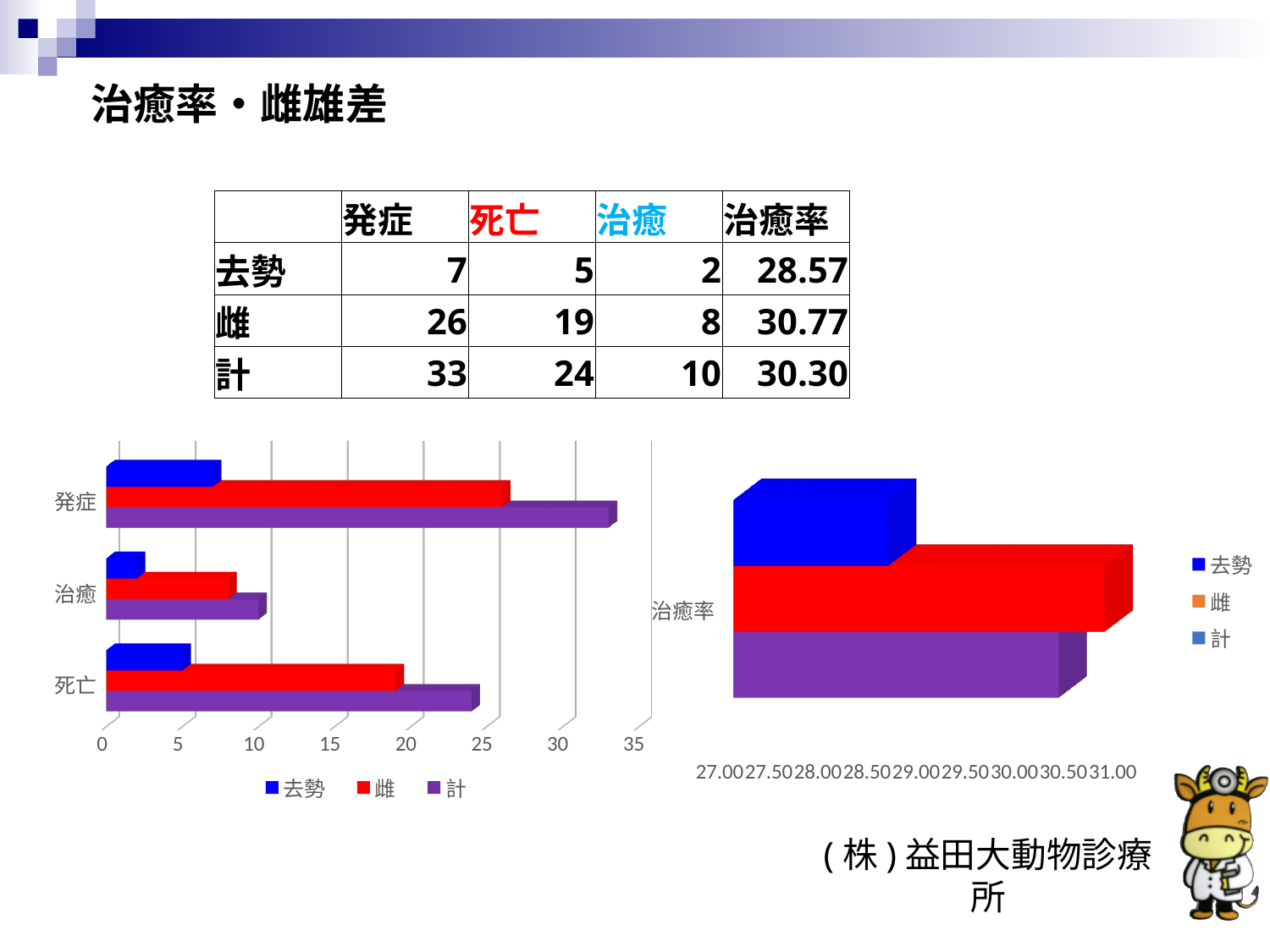
In the left chart, is the 計 bar for 死亡 greater or less than 20? greater How many series does the legend of the left chart list? 3 In the left chart, is the 雌 bar for 発症 greater or less than 25? greater In the left chart, which series has the longest bar for 発症? 計 In the right chart (治癒率), is the 去勢 bar greater or less than 29.00? less In the right chart (治癒率), which series has the longest bar? 雌 What is the title of the slide? 治癒率・雌雄差 How many categories does the left chart show on its vertical axis? 3 What type of chart is the left chart on the slide? bar chart In the left chart, which category has the shortest 去勢 bar? 治癒 In the left chart, which is larger: the 雌 bar for 死亡 or the 雌 bar for 治癒? 死亡